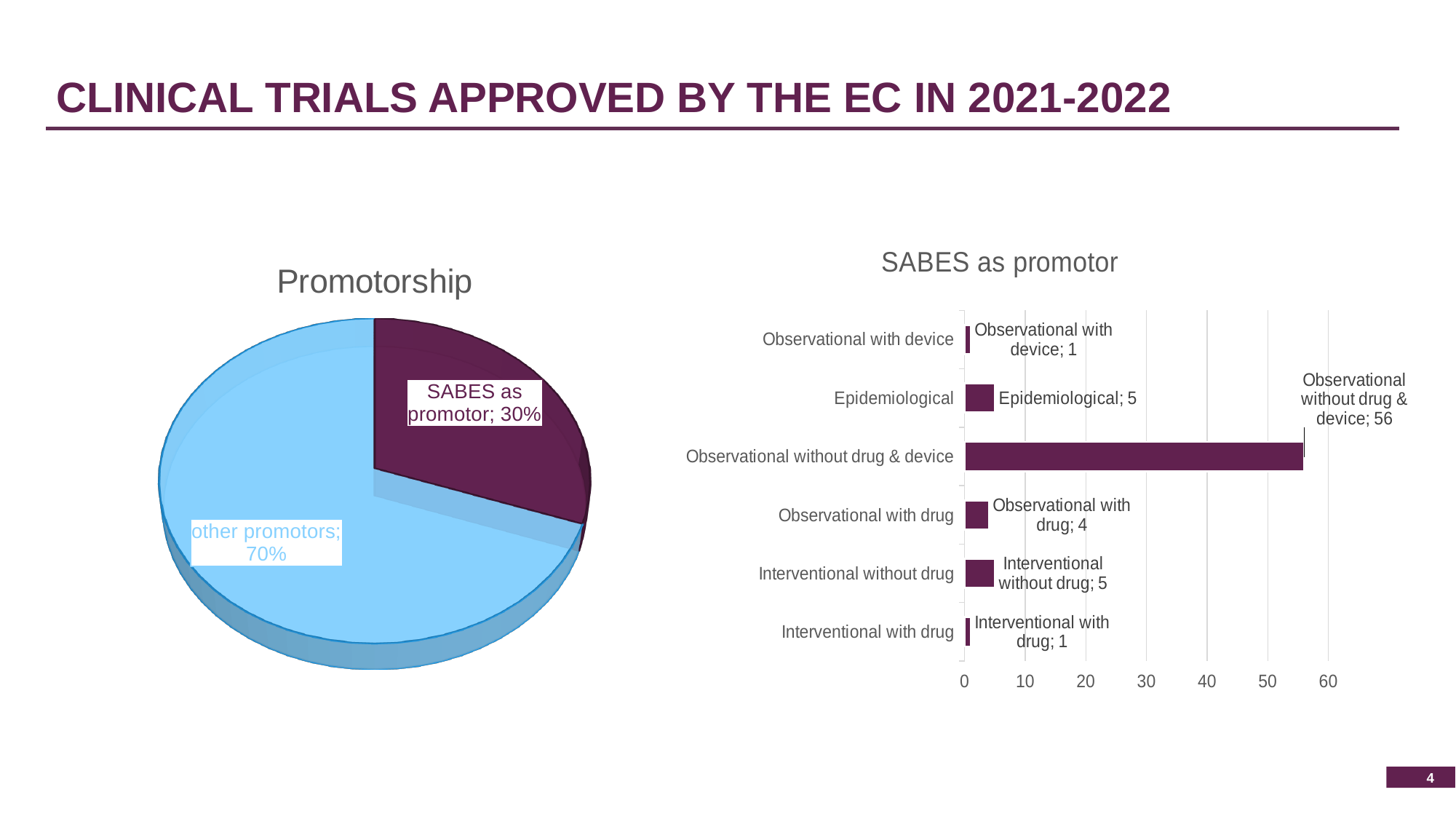
In the 'Promotorship' pie chart, what share of trials has other promotors? 70% In the 'Promotorship' chart, which slice is larger: 'SABES as promotor' or 'other promotors'? other promotors In the 'SABES as promotor' chart, what is the value for 'Observational with drug'? 4 In the 'SABES as promotor' chart, which is larger: 'Interventional without drug' or 'Observational with drug'? Interventional without drug What kind of chart is the 'Promotorship' chart? Pie chart In the 'SABES as promotor' chart, what is the value for 'Observational without drug & device'? 56 What kind of chart is the 'SABES as promotor' chart? Bar chart In the 'Promotorship' pie chart, what share of trials has SABES as promotor? 30% In the 'SABES as promotor' chart, is the value for 'Observational without drug & device' greater or less than 50? greater In the 'SABES as promotor' chart, what is the difference between 'Observational without drug & device' and 'Epidemiological'? 51 In the 'SABES as promotor' chart, which category has the highest value? Observational without drug & device In the 'SABES as promotor' chart, how many categories are shown? 6